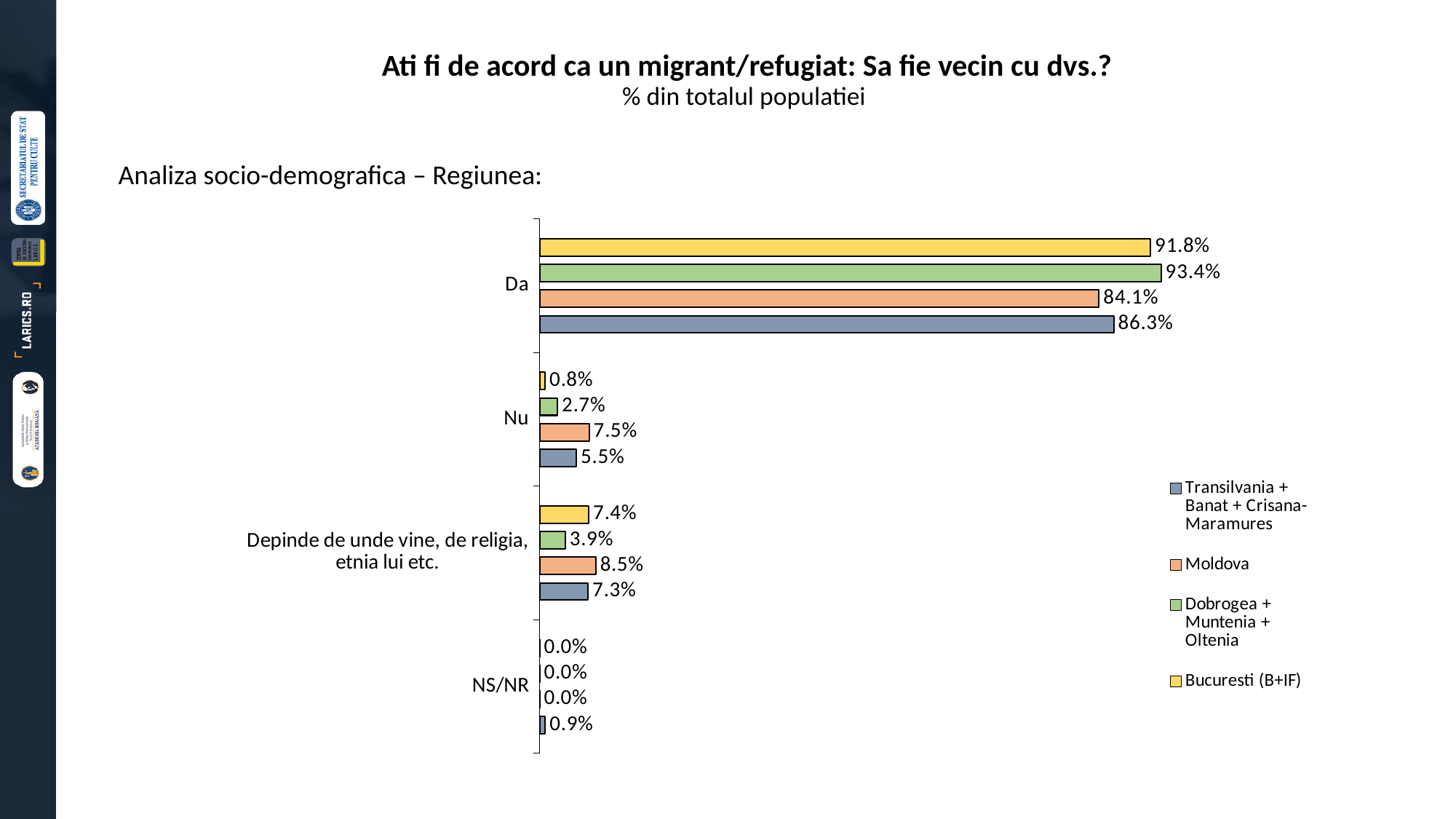
Which colour represents Moldova in the chart? Orange How many answer categories are shown on the chart? 4 What is the value for Bucuresti (B+IF) in the "Nu" category? 0.8% How many series does the legend list? 4 What type of chart is shown on the slide? Bar chart Which region has the highest value for "Da"? Dobrogea + Muntenia + Oltenia What is the value for Transilvania + Banat + Crisana-Maramures in the NS/NR category? 0.9% What percentage of respondents in Moldova answered "Da"? 84.1% What is the value for Dobrogea + Muntenia + Oltenia in the "Depinde de unde vine, de religia, etnia lui etc." category? 3.9% Which is larger in the "Depinde de unde vine, de religia, etnia lui etc." category: Moldova or Bucuresti (B+IF)? Moldova Which region has the lowest value for "Nu"? Bucuresti (B+IF) What is the difference between the "Da" values for Dobrogea + Muntenia + Oltenia and Moldova? 9.3%